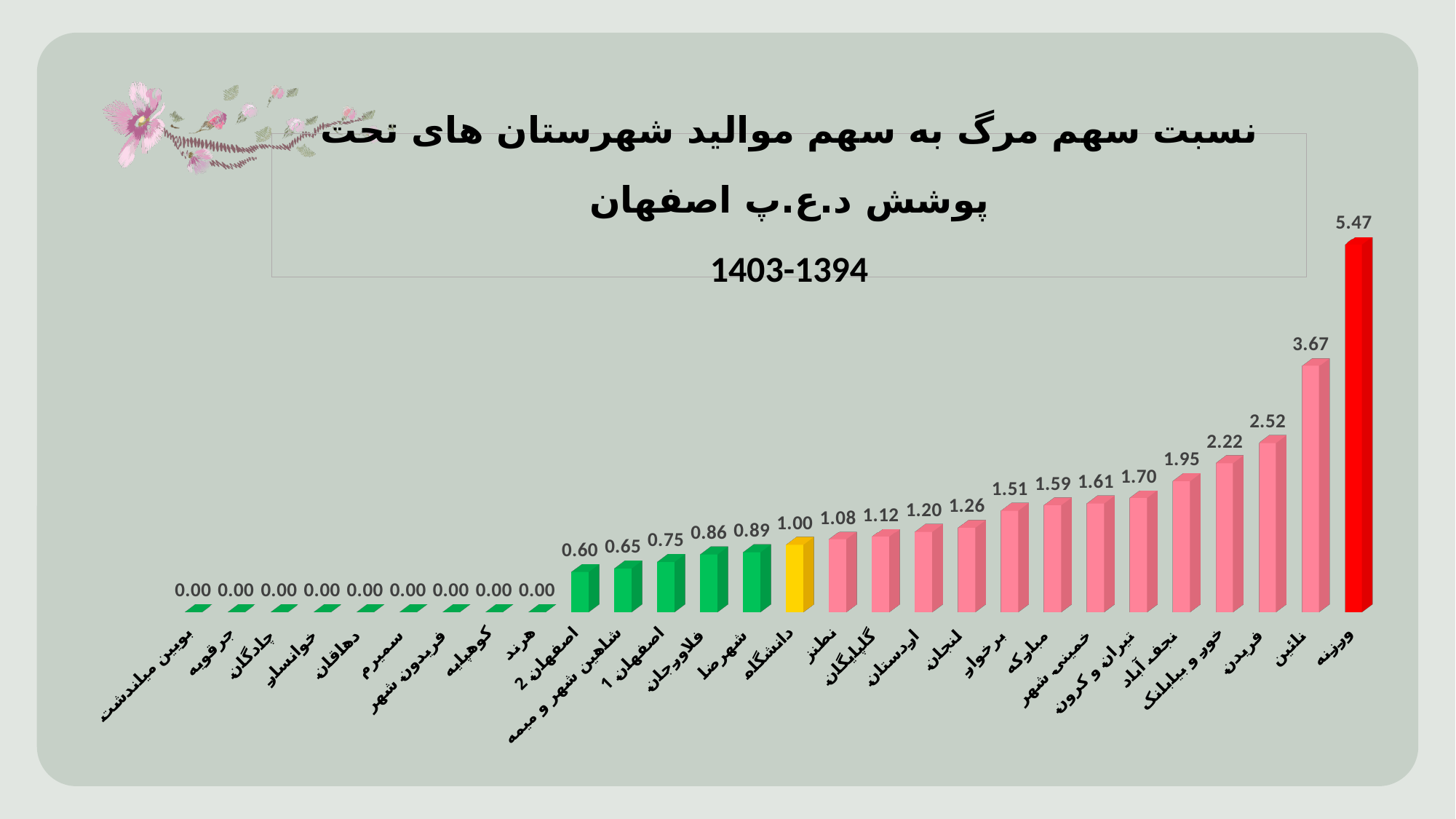
What is the value for نجف آباد? 1.95 What colour is the bar for ورزنه? red Which is larger, the value for فریدن or the value for خور و بیابانک? فریدن How many categories are shown on the x axis? 28 Which category has the highest value? ورزنه What is the value for ورزنه? 5.47 What is the value for اصفهان 2? 0.60 What is the value for نائین? 3.67 What is the difference between the values for ورزنه and نائین? 1.80 What is the value for دانشگاه? 1.00 How many categories have a value of 0.00? 9 What type of chart is shown on the slide? bar chart